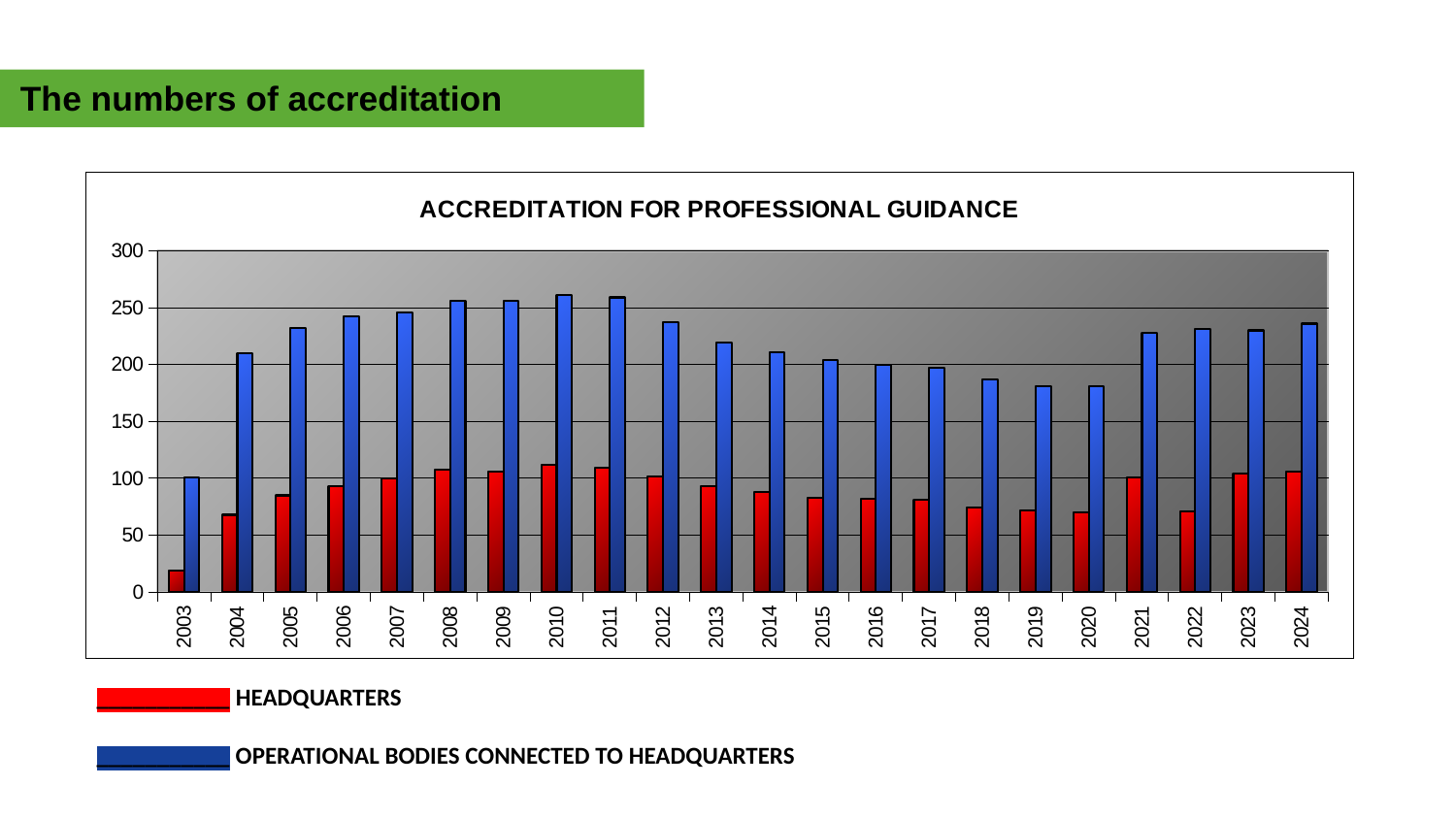
Is the value for OPERATIONAL BODIES CONNECTED TO HEADQUARTERS in 2020 greater or less than 200? less What kind of chart is shown on the slide? Bar chart How many series does the legend list? 2 In which year is the value for HEADQUARTERS lowest? 2003 Is the value for HEADQUARTERS in 2003 greater or less than 50? less What is the title of the chart? ACCREDITATION FOR PROFESSIONAL GUIDANCE Which colour represents HEADQUARTERS in the chart? Red Is the value for OPERATIONAL BODIES CONNECTED TO HEADQUARTERS in 2004 greater or less than 200? greater In which year is the value for OPERATIONAL BODIES CONNECTED TO HEADQUARTERS lowest? 2003 How many years are shown along the x axis of the chart? 22 Which is larger: the OPERATIONAL BODIES CONNECTED TO HEADQUARTERS value in 2010 or in 2020? 2010 Do the values for OPERATIONAL BODIES CONNECTED TO HEADQUARTERS rise or fall from 2011 to 2020? Fall